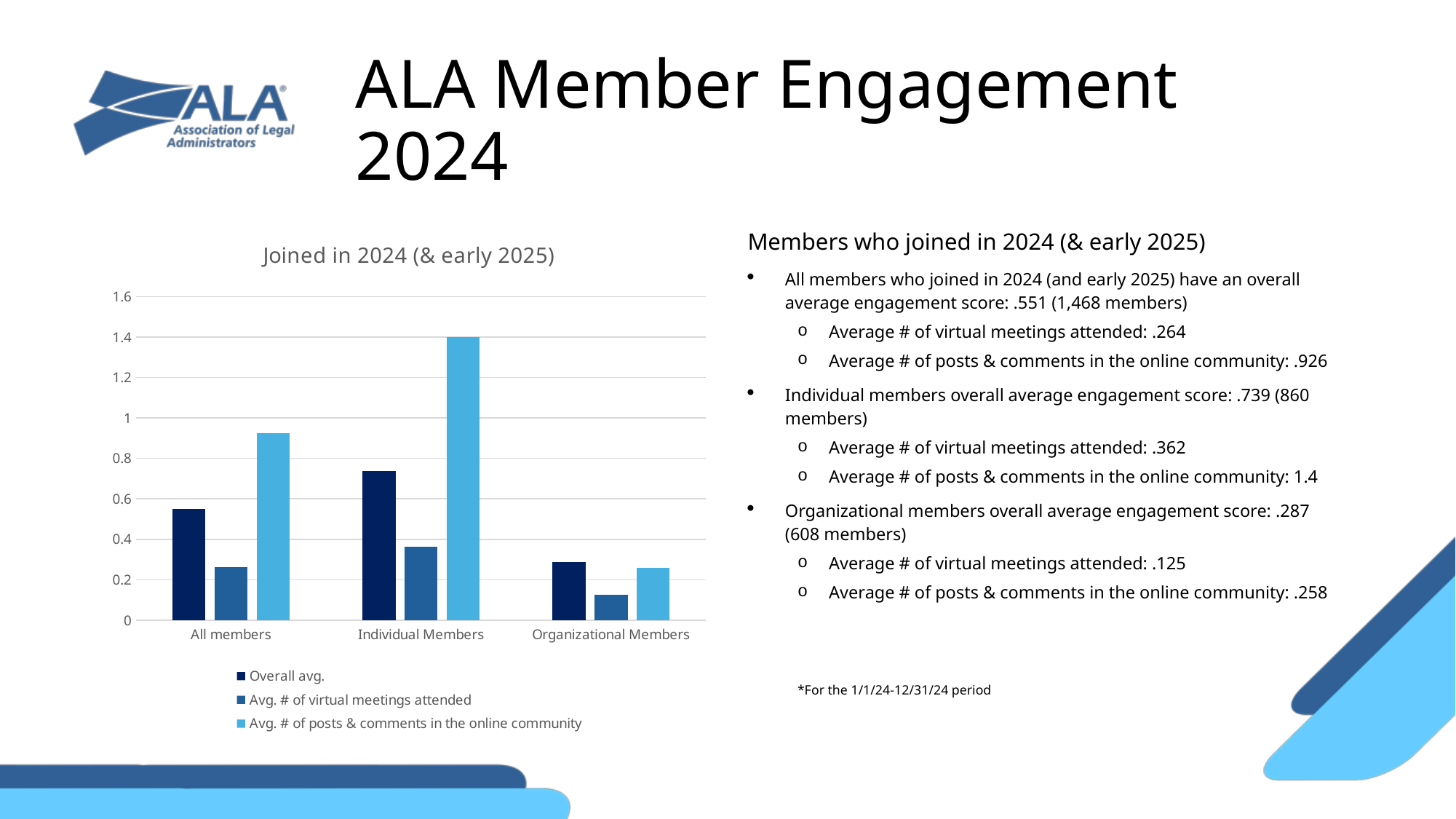
Which is larger: the Overall avg. for Individual Members or the Overall avg. for Organizational Members? Individual Members What is the Overall avg. value for All members? .551 Which category has the lowest Avg. # of posts & comments in the online community bar? Organizational Members How many categories are shown on the x axis of the chart? 3 How many series does the chart legend list? 3 What is the title of the chart? Joined in 2024 (& early 2025) Is the Avg. # of posts & comments in the online community for All members greater or less than 0.8? greater What is the value of Avg. # of posts & comments in the online community for Individual Members? 1.4 What kind of chart is shown on the slide? bar chart Which category has the highest Overall avg. bar? Individual Members Is the Overall avg. for Organizational Members greater or less than 0.4? less What is the Avg. # of virtual meetings attended for Organizational Members? .125